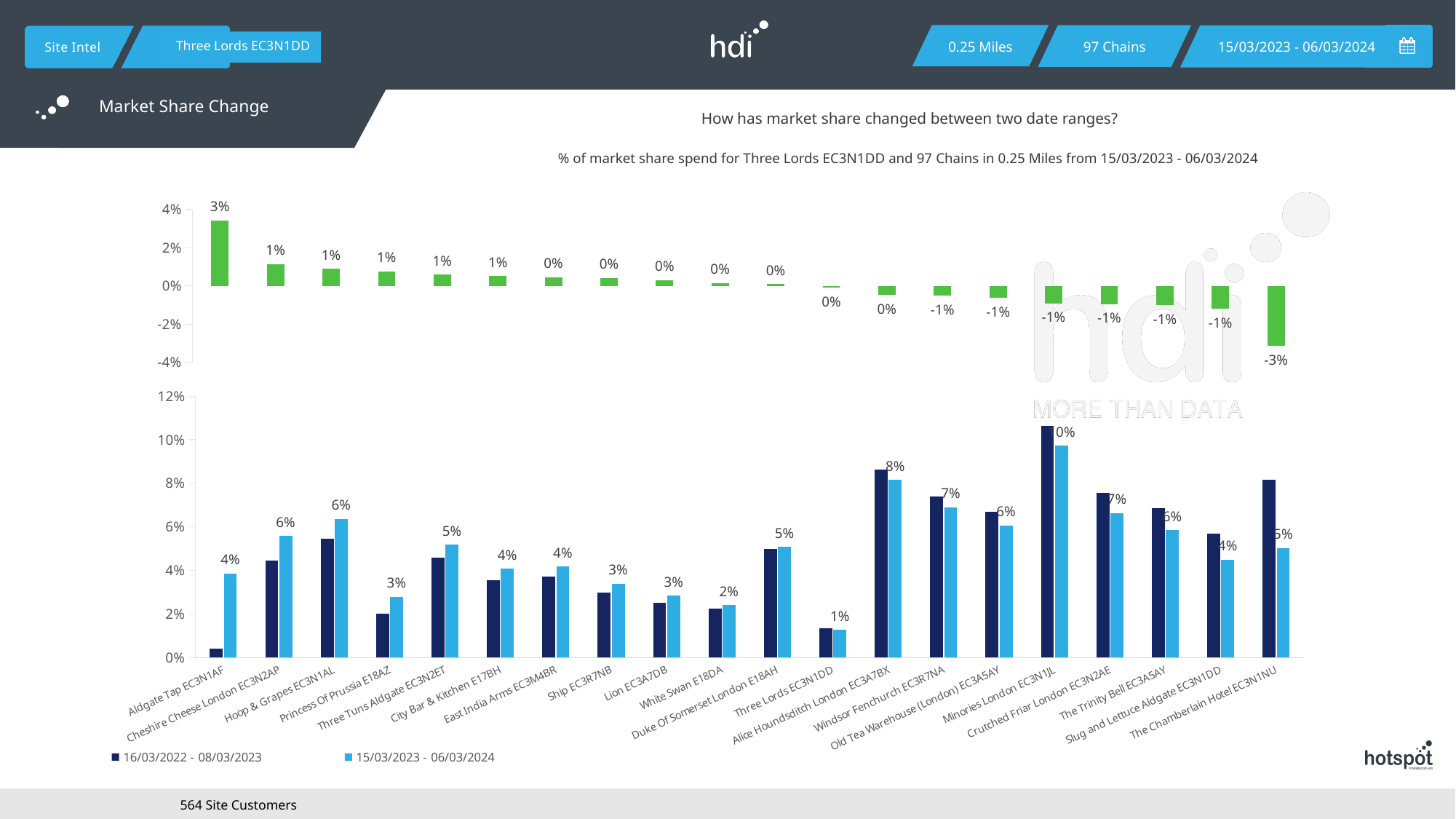
In the top chart (market share change), which category has the lowest value? The Chamberlain Hotel EC3N1NU In the bottom chart, which category has the highest 15/03/2023 - 06/03/2024 value? Minories London EC3N1JL In the top chart (market share change), what is the difference between the values for Aldgate Tap EC3N1AF and Cheshire Cheese London EC3N2AP? 2% What kind of chart is the bottom chart? Bar chart In the bottom chart, is the 16/03/2022 - 08/03/2023 value for Aldgate Tap EC3N1AF greater or less than 2%? less In the bottom chart, which has the larger 15/03/2023 - 06/03/2024 value: Hoop & Grapes EC3N1AL or Princess Of Prussia E18AZ? Hoop & Grapes EC3N1AL In the bottom chart, what is the 15/03/2023 - 06/03/2024 value for Three Lords EC3N1DD? 1% How many series does the legend of the bottom chart list? 2 How many categories are shown on the x axis of the bottom chart? 20 In the top chart (market share change), which category has the highest value? Aldgate Tap EC3N1AF In the bottom chart, what is the 15/03/2023 - 06/03/2024 value for Minories London EC3N1JL? 10% In the top chart (market share change), what is the value for Aldgate Tap EC3N1AF? 3%